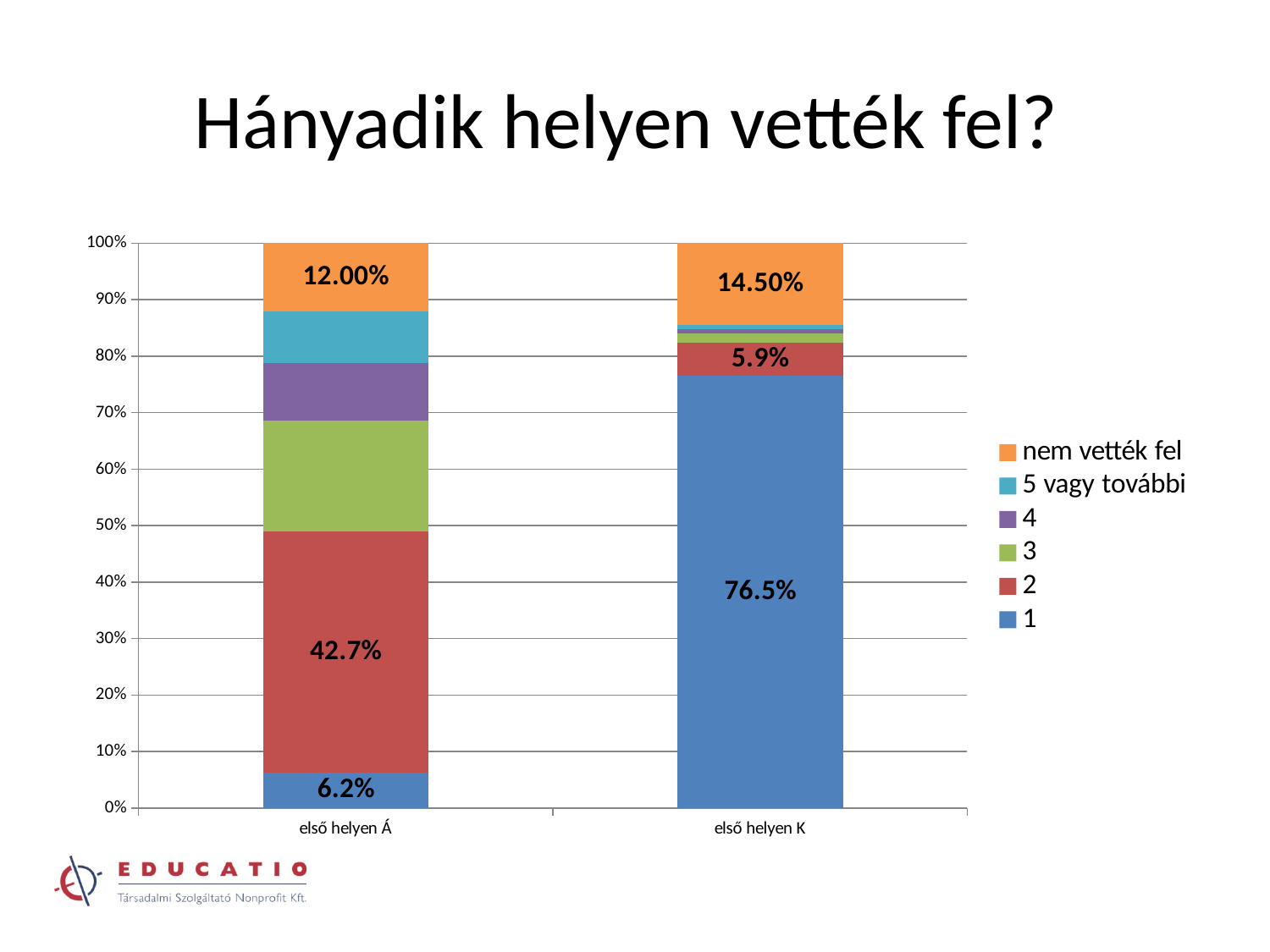
What is the value of "nem vették fel" for "első helyen K"? 14.50% How many categories are shown on the x axis? 2 What is the value of series "2" for "első helyen K"? 5.9% What is the value of series "1" for "első helyen K"? 76.5% What kind of chart is shown on the slide? stacked bar chart What is the value of series "2" for "első helyen Á"? 42.7% What is the difference between the series "2" values for "első helyen Á" and "első helyen K"? 36.8% What is the title of the slide? Hányadik helyen vették fel? How many series does the legend list? 6 What is the value of "nem vették fel" for "első helyen Á"? 12.00% Which category has the larger value for series "1", "első helyen Á" or "első helyen K"? első helyen K What is the value of series "1" for "első helyen Á"? 6.2%